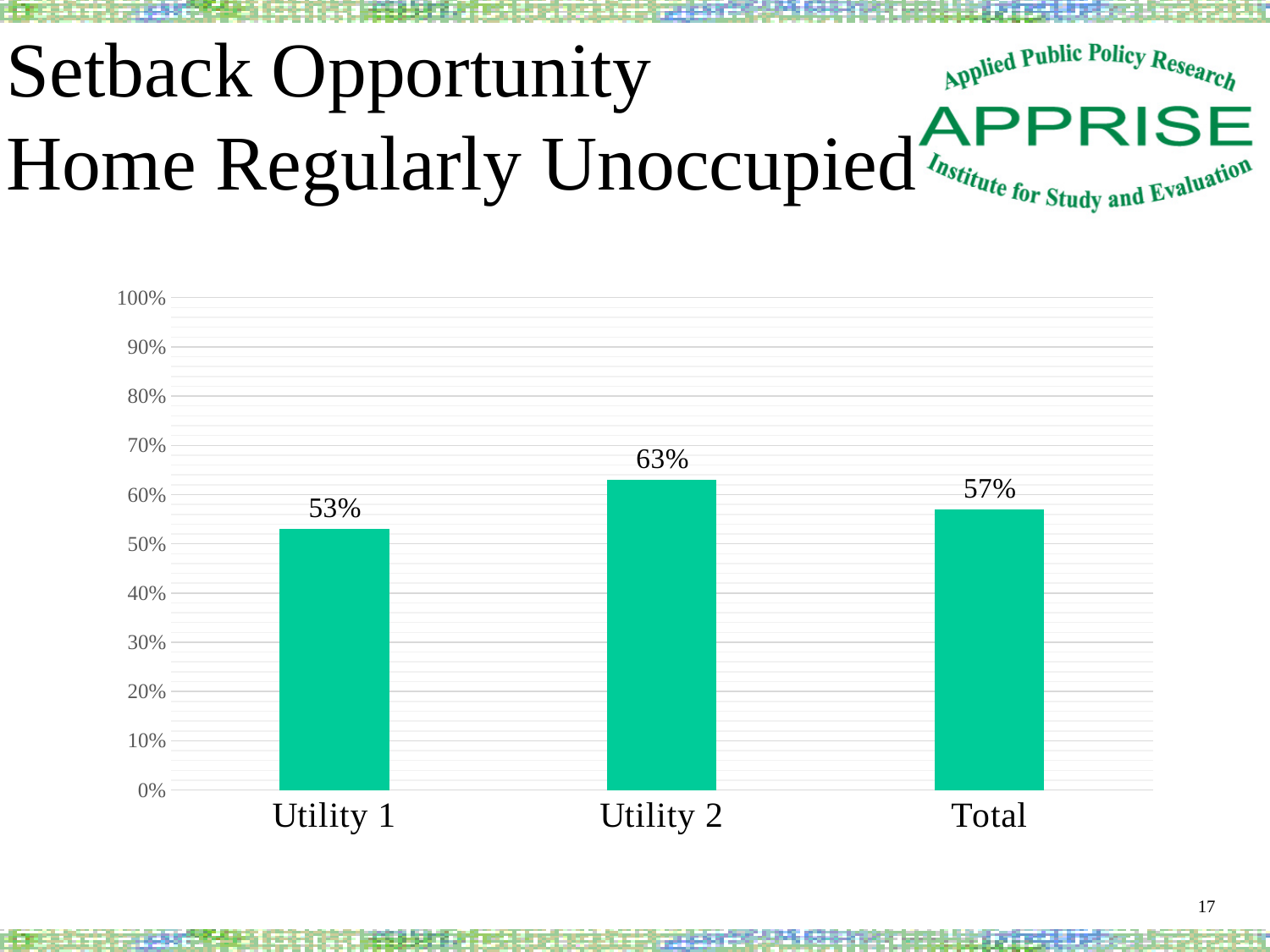
Which category has the lowest value? Utility 1 What kind of chart is shown on the slide? bar chart Is the value for Utility 2 greater or less than 60%? greater Which category has the highest value? Utility 2 What is the value for Total? 57% How many categories are shown on the x axis? 3 What is the difference between the values for Utility 2 and Total? 6% What is the value for Utility 2? 63% Which is larger, the value for Utility 1 or the value for Total? Total What is the value for Utility 1? 53% What is the difference between the values for Utility 2 and Utility 1? 10% What is the title of the slide containing the chart? Setback Opportunity Home Regularly Unoccupied